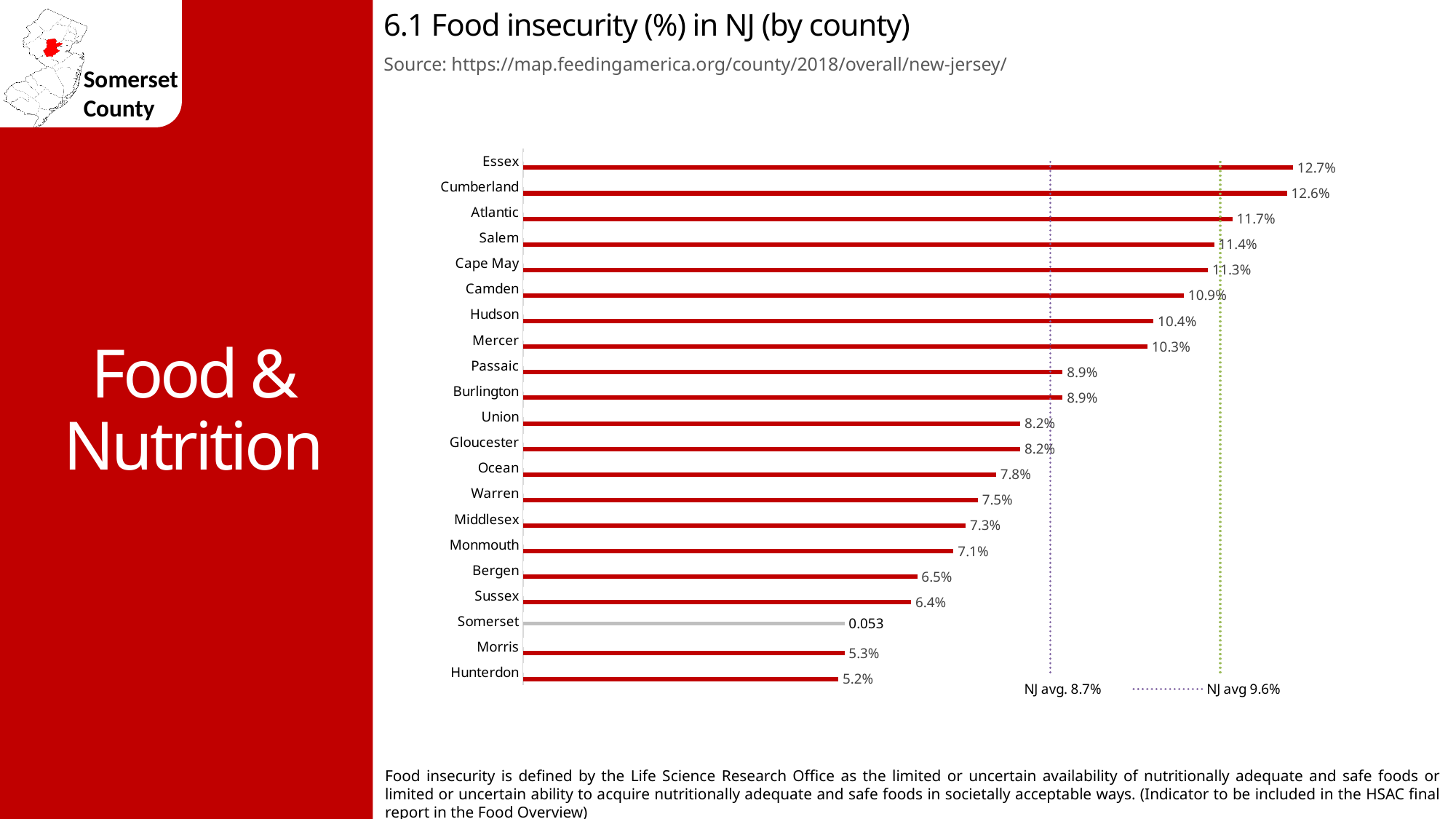
What is the difference in percentage points between Camden and Mercer? 0.6 What is the difference in percentage points between Essex and Hunterdon? 7.5 How many counties are shown in the chart? 21 What two reference values are labelled by the dotted vertical lines? NJ avg. 8.7% and NJ avg 9.6% Which has a higher food insecurity percentage, Atlantic or Ocean? Atlantic What is the food insecurity value for Bergen county? 6.5% What is the food insecurity value for Essex county? 12.7% What is the food insecurity value for Hudson county? 10.4% Which county has the highest food insecurity percentage? Essex What kind of chart is shown on the slide? Bar chart What value is printed for Somerset county? 0.053 Which county has the lowest food insecurity percentage? Hunterdon